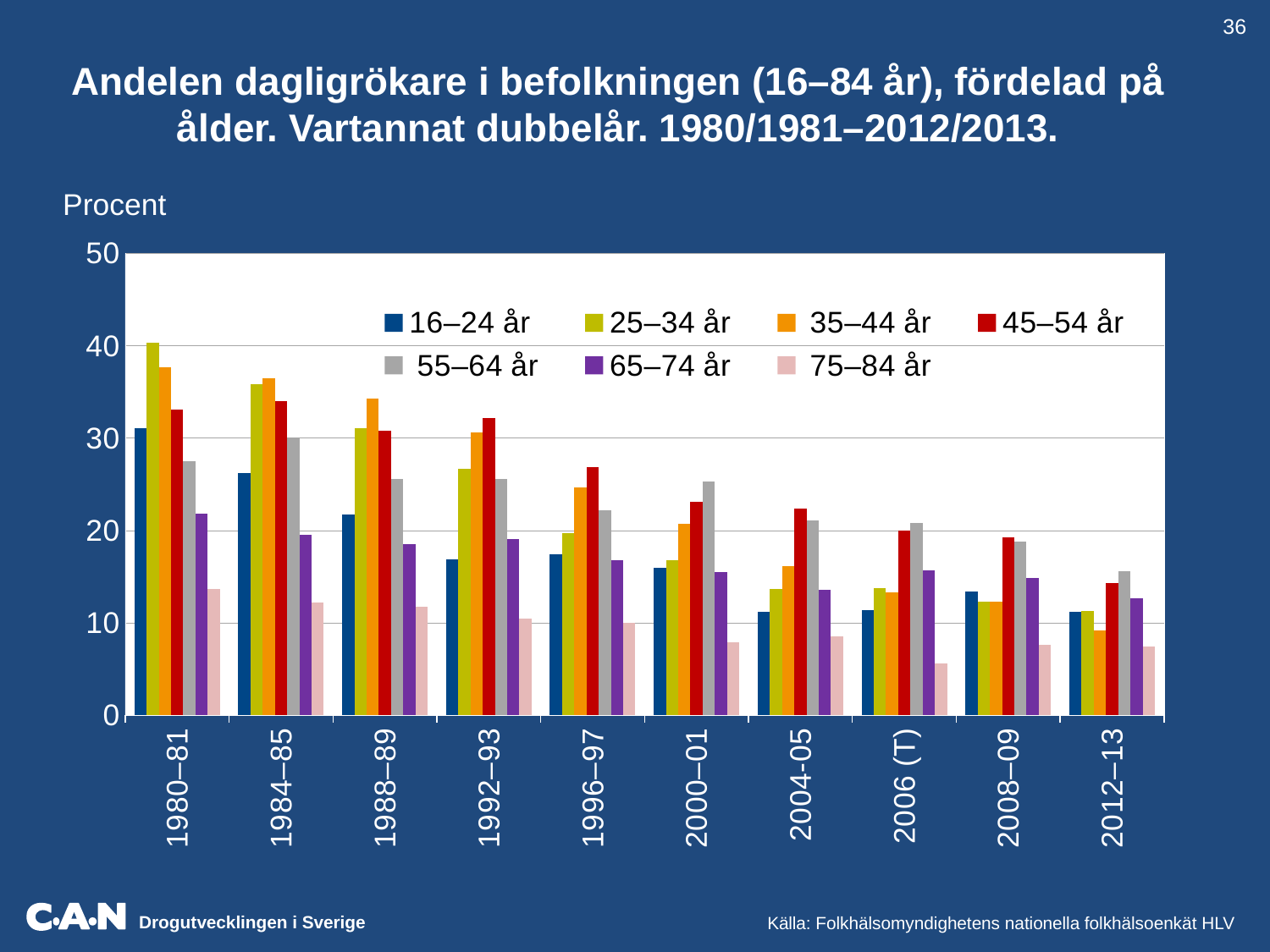
What unit label is shown above the y axis? Procent What kind of chart is shown on the slide? Bar chart Is the value for 75–84 år in 2006 (T) greater or less than 10? less In 2000–01, which is larger: the value for 55–64 år or the value for 45–54 år? 55–64 år How many time periods are shown along the x axis? 10 How many age groups (series) does the legend list? 7 Is the value for 35–44 år in 1988–89 greater or less than 30? greater Which age group has the lowest share of daily smokers in 1980–81? 75–84 år Does the share of daily smokers among 16–24 år rise or fall from 1980–81 to 2012–13? Fall Which age group has the highest share of daily smokers in 1980–81? 25–34 år Is the value for 45–54 år in 1996–97 greater or less than 20? greater In 1980–81, which is larger: the value for 16–24 år or the value for 65–74 år? 16–24 år